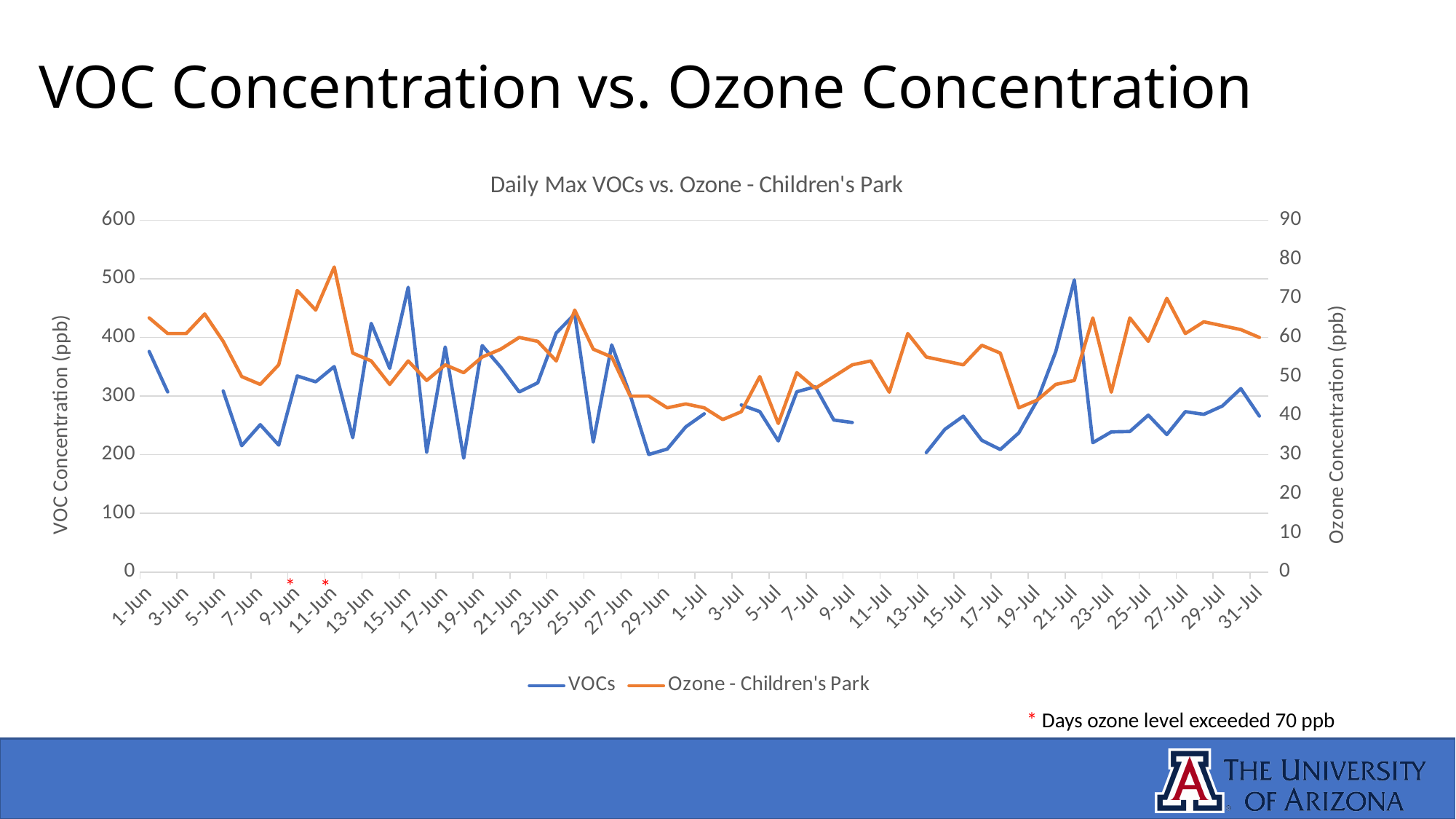
Is the ozone value on 3-Jul greater or less than 50? less Is the ozone value on 11-Jun greater or less than 70? greater What type of chart is shown on the slide? line chart How many dates are marked with a red asterisk on the x axis? 2 Is the VOC value on 21-Jul greater or less than 400? greater How many series does the chart legend list? 2 What is the title of the chart? Daily Max VOCs vs. Ozone - Children's Park On which date does the Ozone - Children's Park line reach its highest point? 11-Jun What is the label of the right-hand vertical axis? Ozone Concentration (ppb)